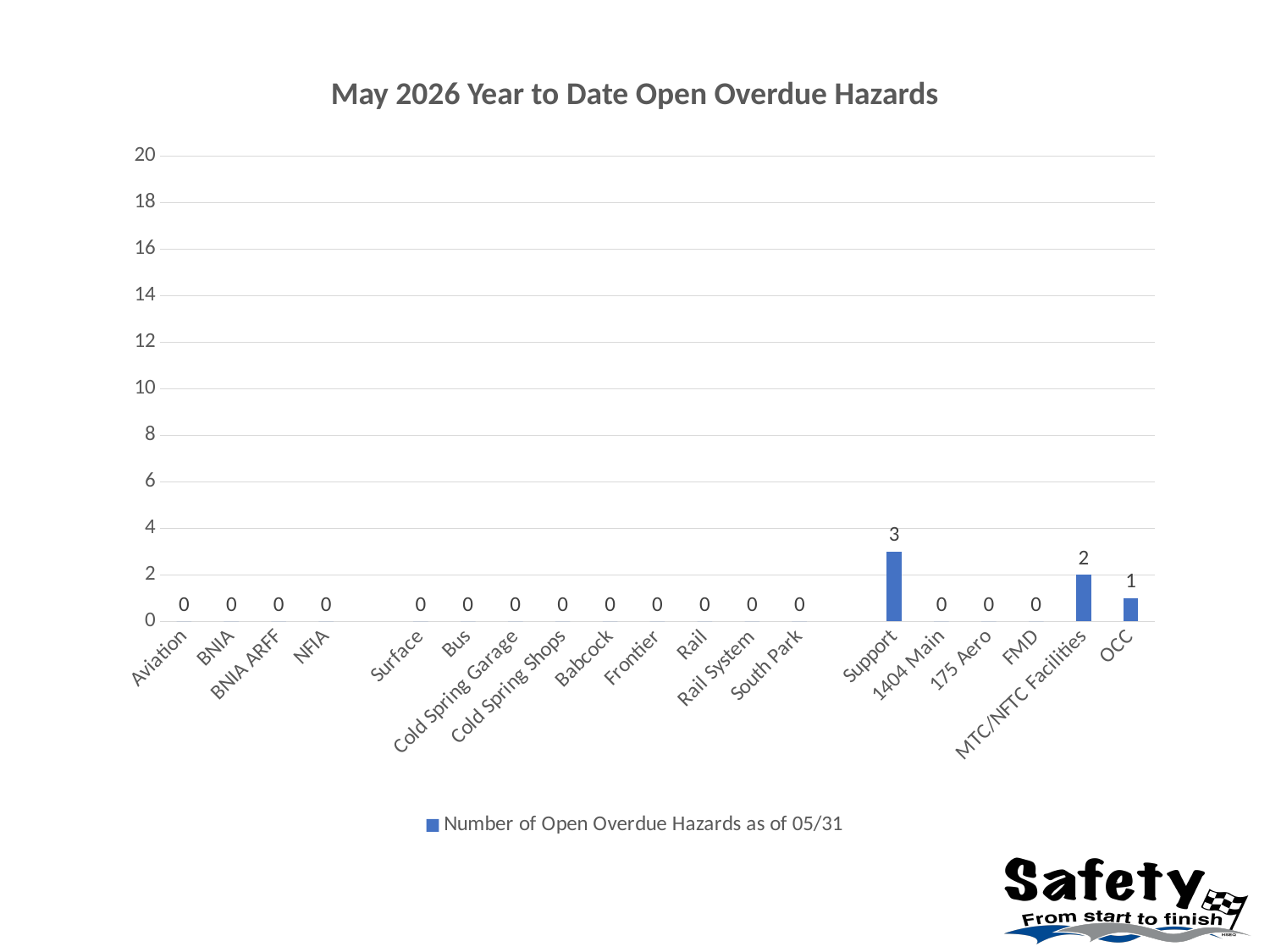
What is the title of the chart? May 2026 Year to Date Open Overdue Hazards What is the difference between the values for Support and OCC? 2 Which category has the highest value? Support What is the value for MTC/NFTC Facilities? 2 What is the legend entry for the series? Number of Open Overdue Hazards as of 05/31 What kind of chart is shown? bar chart How many series does the legend list? 1 What is the value for Aviation? 0 What is the value for Support? 3 Is the value for Support greater or less than 4? less Which is larger, the value for MTC/NFTC Facilities or the value for OCC? MTC/NFTC Facilities What is the value for OCC? 1